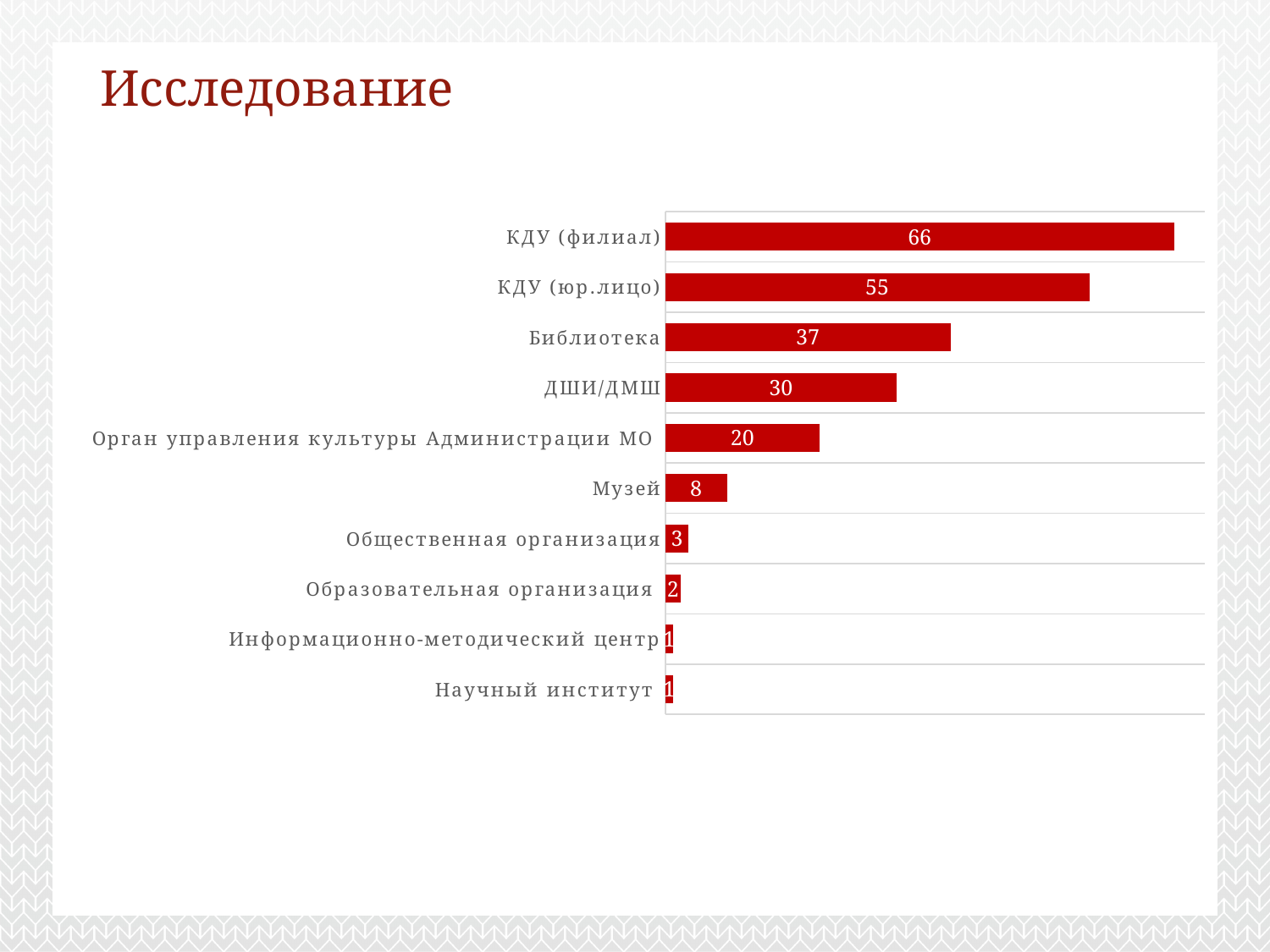
What is the value for Орган управления культуры Администрации МО? 20 How many categories are shown in the chart? 10 What is the value for КДУ (филиал)? 66 What is the difference between the values for КДУ (филиал) and КДУ (юр.лицо)? 11 What is the value for Музей? 8 Which is larger, the value for ДШИ/ДМШ or the value for Орган управления культуры Администрации МО? ДШИ/ДМШ What kind of chart is shown on the slide? bar chart What is the value for Библиотека? 37 What colour are the bars in the chart? red What is the difference between the values for Библиотека and ДШИ/ДМШ? 7 What is the title of the slide? Исследование Which category has the highest value? КДУ (филиал)